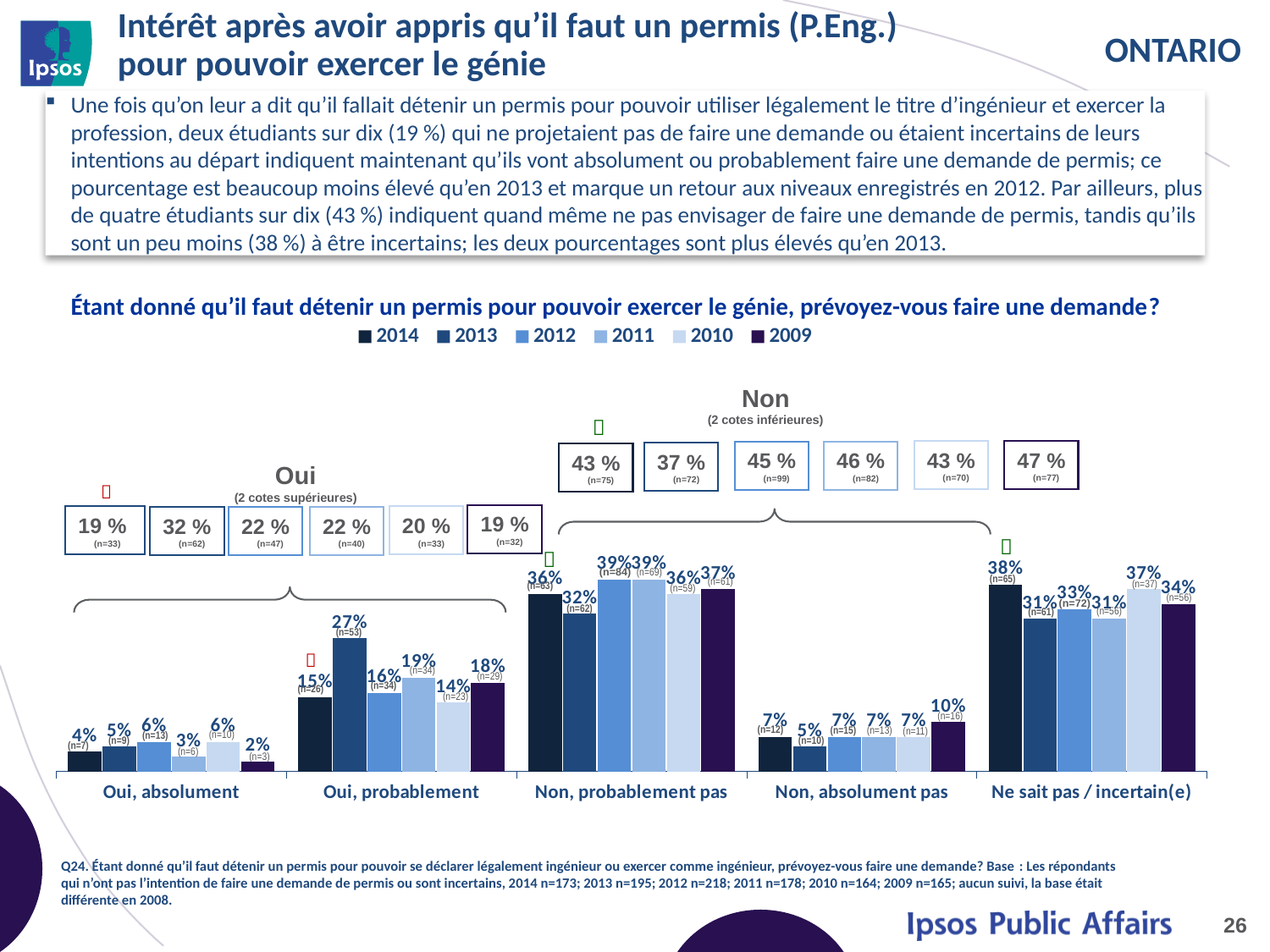
How many response categories are shown on the x axis? 5 What is the value for 2009 in the "Non, absolument pas" category? 10% Which year has the lowest value in the "Oui, absolument" category? 2009 According to the summary box, what is the 2013 "Oui (2 cotes supérieures)" percentage? 32 % What kind of chart is shown on the slide? Bar chart Which year has the highest value in the "Oui, probablement" category? 2013 According to the summary box, what is the 2009 "Non (2 cotes inférieures)" percentage? 47 % What is the difference between the 2013 and 2014 values in the "Oui, probablement" category? 12% What is the value for 2014 in the "Ne sait pas / incertain(e)" category? 38% What is the value for 2013 in the "Oui, probablement" category? 27% How many years does the legend list? 6 In the "Ne sait pas / incertain(e)" category, which is larger: the value for 2014 or the value for 2013? 2014